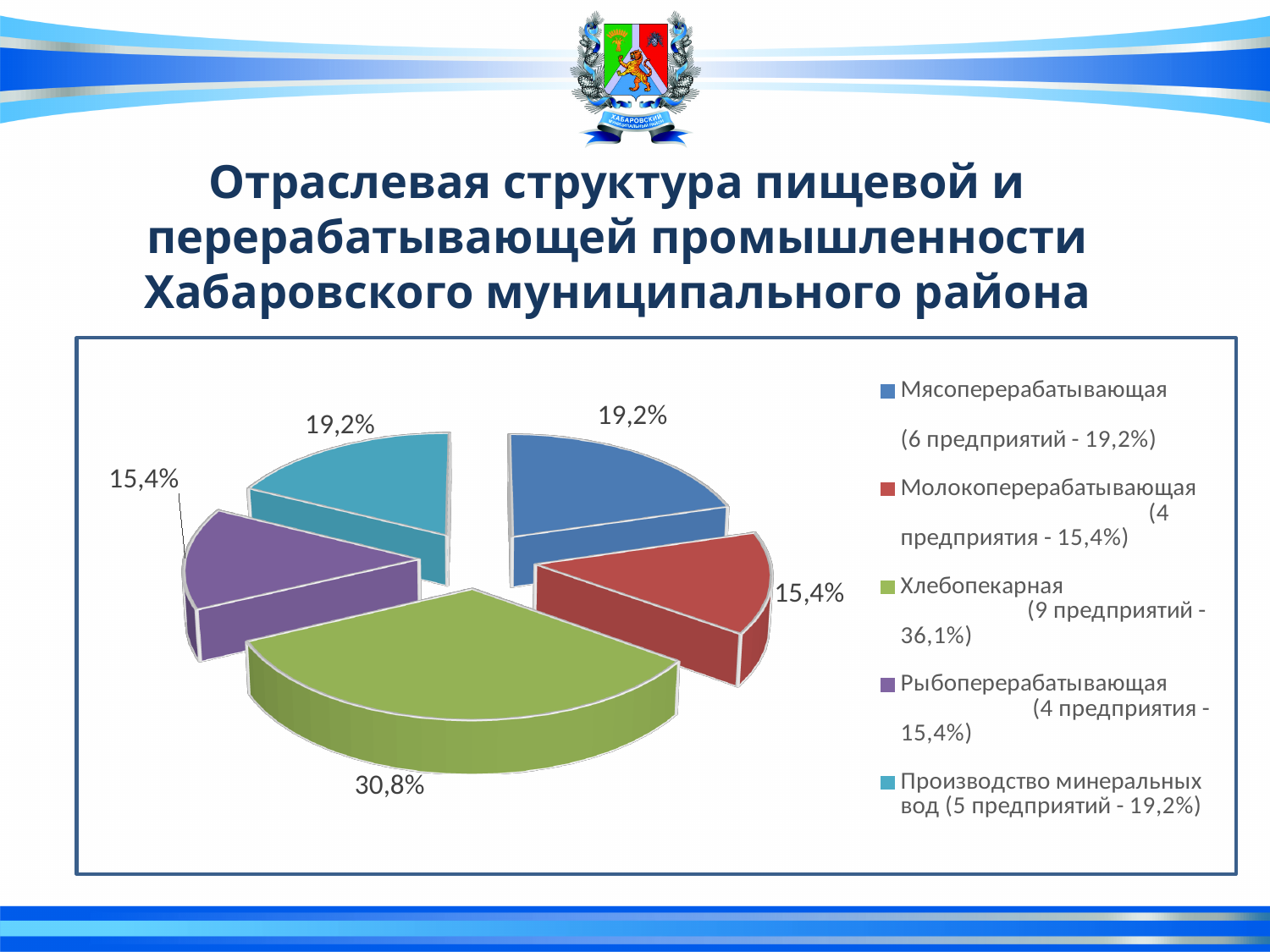
What colour is the Хлебопекарная slice in the pie chart? green What type of chart is shown on the slide? pie chart What percentage is shown for Мясоперерабатывающая? 19,2% Which share is larger: Мясоперерабатывающая or Рыбоперерабатывающая? Мясоперерабатывающая What percentage is shown for Молокоперерабатывающая? 15,4% How many slices does the pie chart have? 5 What percentage is shown for Производство минеральных вод? 19,2% According to the legend, how many enterprises are in the Хлебопекарная sector? 9 Which sector has the largest share of the pie? Хлебопекарная How many entries does the legend of the pie chart list? 5 What data label is printed next to the green slice (Хлебопекарная) on the pie chart? 30,8% What is the difference in percentage points between the Мясоперерабатывающая share (19,2%) and the Рыбоперерабатывающая share (15,4%)? 3,8 percentage points